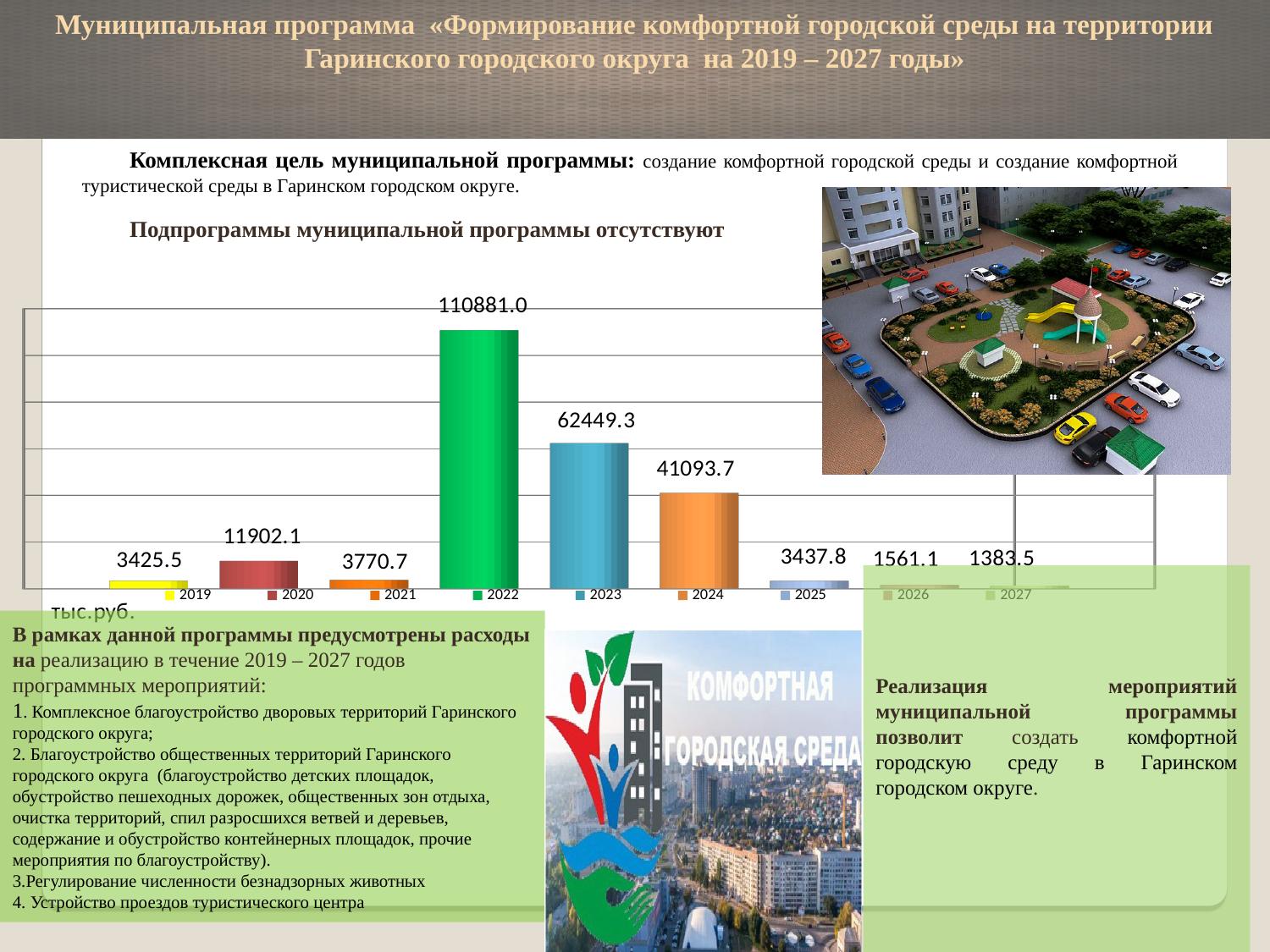
What unit is indicated below the chart? тыс.руб. Which year has the lowest value? 2027 What is the value shown for 2023? 62449.3 Which is larger, the value for 2020 or the value for 2021? 2020 How many years are shown on the chart? 9 What is the value shown for 2020? 11902.1 What is the value shown for 2027? 1383.5 What kind of chart is shown on the slide? bar chart What is the value shown for 2022? 110881.0 Which year has the highest value? 2022 What is the difference between the values for 2022 and 2023? 48431.7 What is the difference between the values for 2023 and 2024? 21355.6